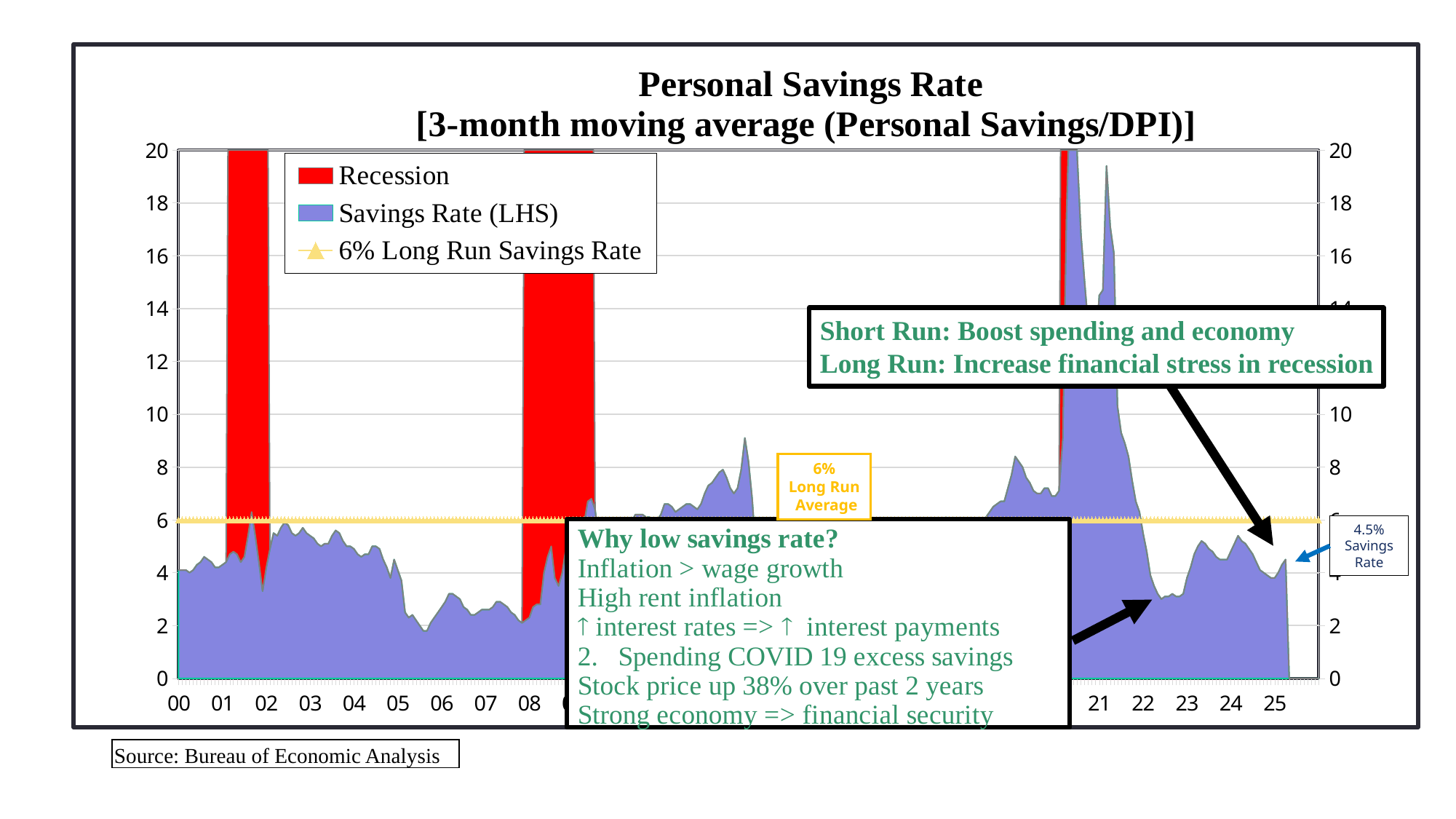
Is the savings rate in 2023 greater or less than 6? less What is the long run savings rate shown by the horizontal line? 6% What kind of chart is shown on the slide? area chart Does the savings rate rise or fall from 2021 to 2023? fall What savings rate is annotated at the end of the series in 2025? 4.5% What is the source cited for the chart data? Bureau of Economic Analysis What is the title of the chart? Personal Savings Rate [3-month moving average (Personal Savings/DPI)] Is the savings rate in 2005 greater or less than 4? less How many entries does the chart legend list? 3 How many recession periods are shaded on the chart? 3 Is the peak savings rate in 2020 greater or less than 18? greater Which is higher, the savings rate peak in 2020 or the peak around 2009? 2020